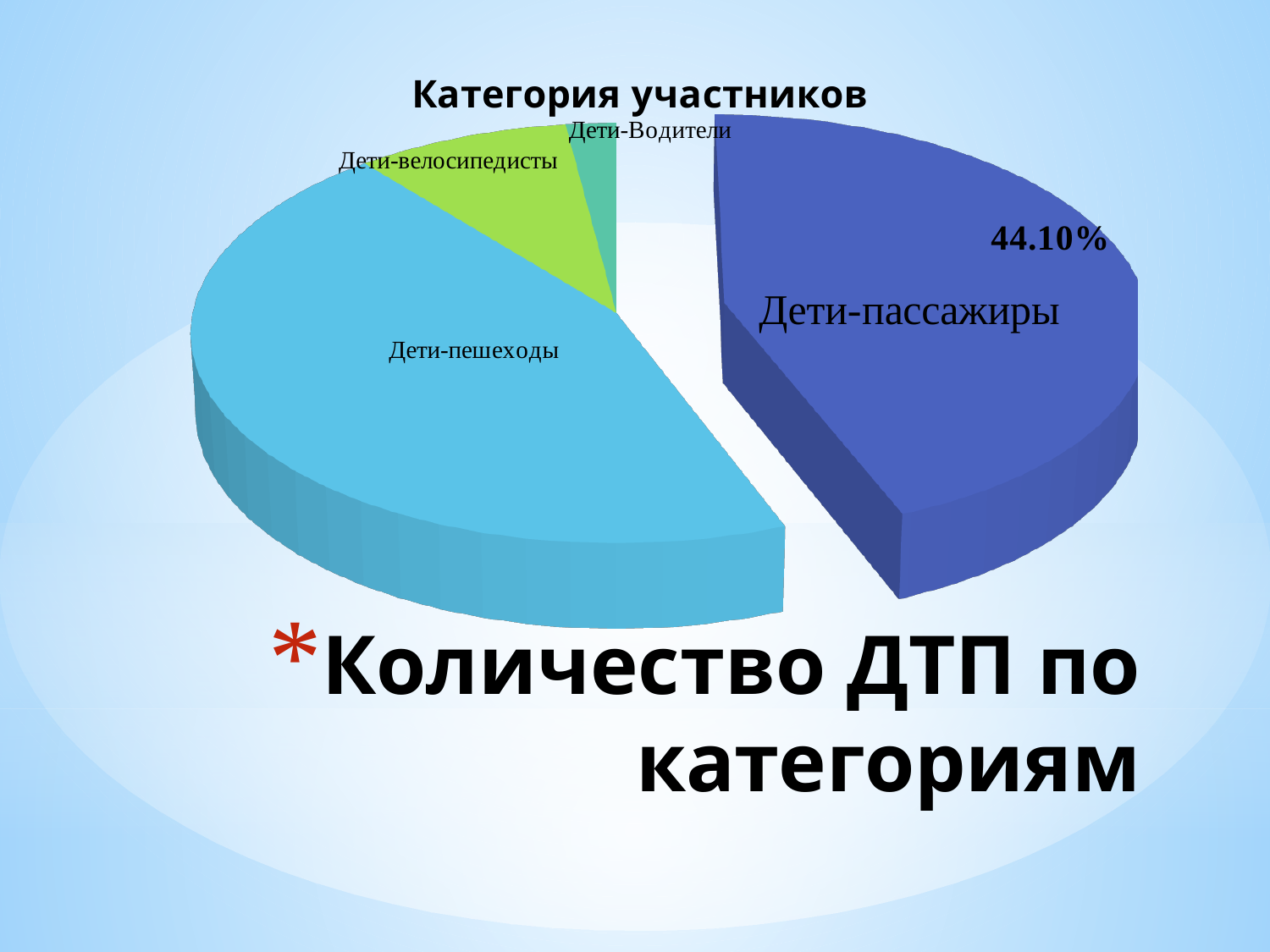
What is the title of the chart? Категория участников Which slice is larger: Дети-велосипедисты or Дети-Водители? Дети-велосипедисты Which category has the smallest slice of the pie? Дети-Водители Which slice is larger: Дети-пассажиры or Дети-велосипедисты? Дети-пассажиры What kind of chart is shown on the slide? Pie chart What share of the pie does the Дети-пассажиры slice represent? 44.10% How many categories are shown in the pie chart? 4 Which slice is larger: Дети-пешеходы or Дети-Водители? Дети-пешеходы Which slice of the pie is pulled out (exploded) from the rest? Дети-пассажиры What value is printed on the Дети-пассажиры slice? 44.10%